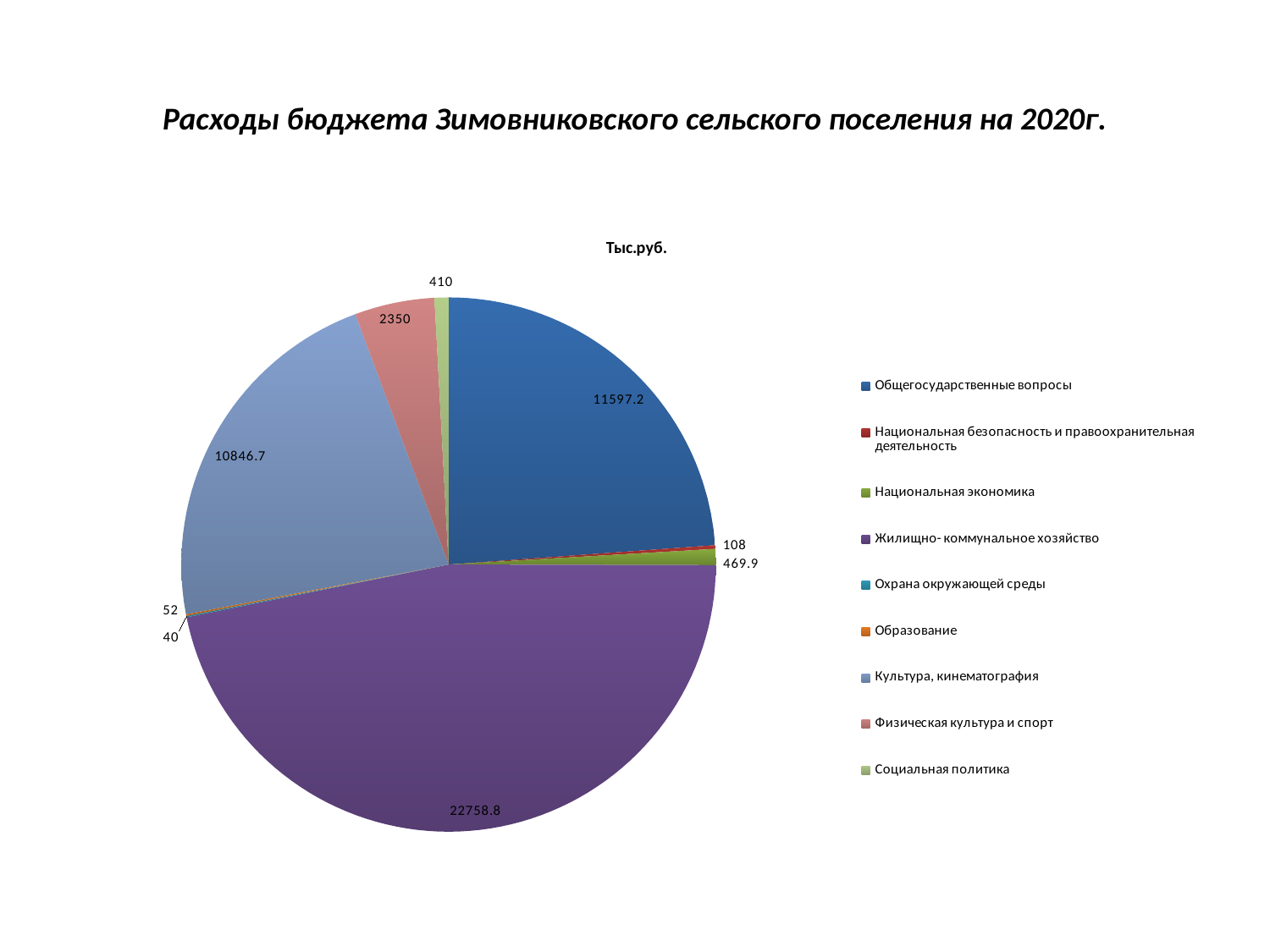
What is the value for Культура, кинематография? 10846.7 What is the value for Жилищно-коммунальное хозяйство? 22758.8 Which category has the largest slice of the pie? Жилищно-коммунальное хозяйство What is the value for Общегосударственные вопросы? 11597.2 What is the difference between Жилищно-коммунальное хозяйство and Общегосударственные вопросы? 11161.6 How many categories does the legend list? 9 What is the value for Физическая культура и спорт? 2350 What kind of chart is shown on the slide? pie chart What is the title shown above the pie chart? Тыс.руб. What is the difference between Физическая культура и спорт and Социальная политика? 1940 What is the value for Социальная политика? 410 Which is larger, Общегосударственные вопросы or Культура, кинематография? Общегосударственные вопросы